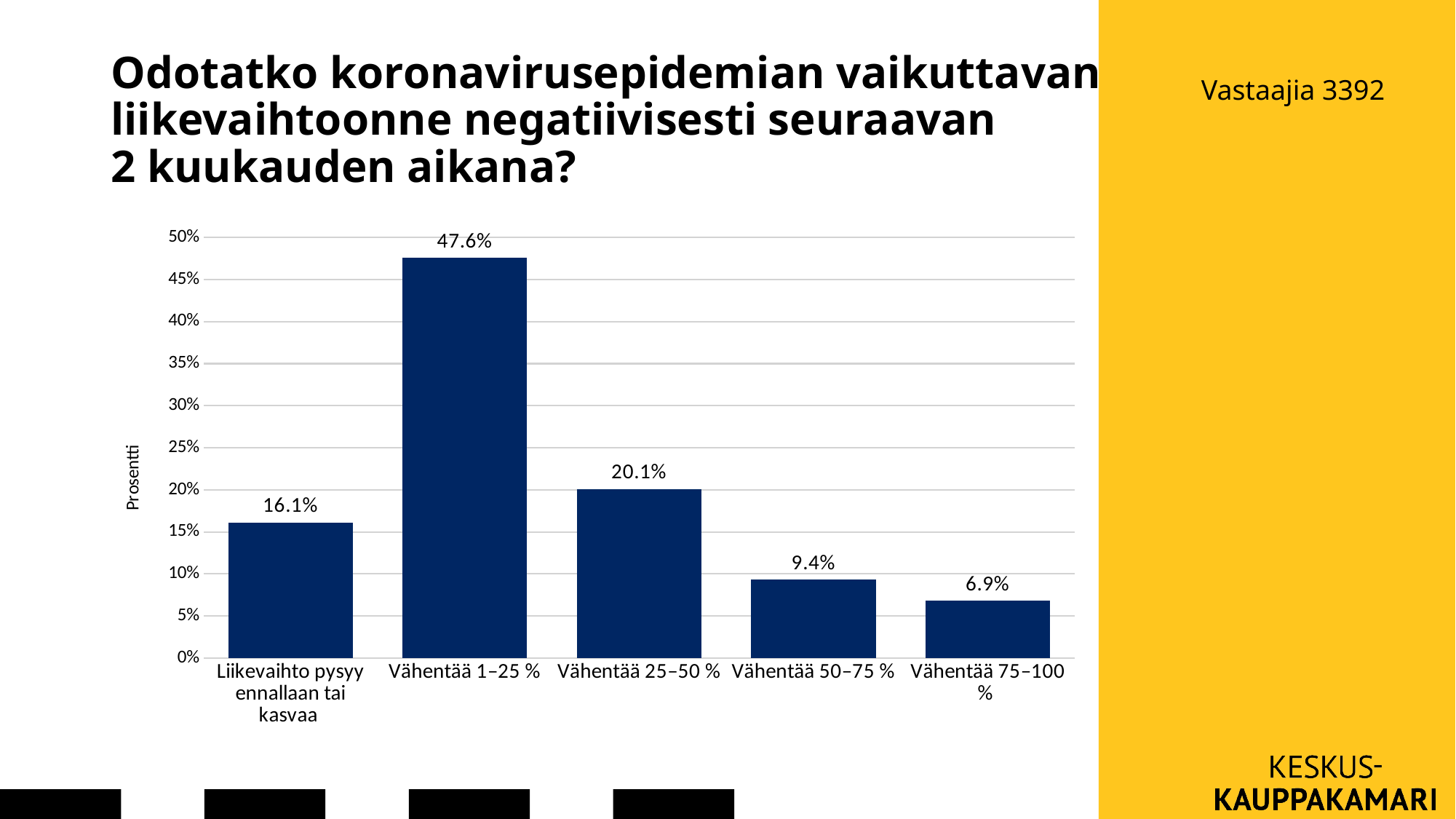
Which is larger: the value for "Liikevaihto pysyy ennallaan tai kasvaa" or the value for "Vähentää 25–50 %"? Vähentää 25–50 % What is the difference between the values for "Vähentää 1–25 %" and "Vähentää 25–50 %"? 27.5% What is the value for "Vähentää 50–75 %"? 9.4% What is the value for "Vähentää 1–25 %"? 47.6% What is the label of the y axis? Prosentti Is the value for "Vähentää 75–100 %" greater or less than 10%? less How many categories are shown on the x axis? 5 How many respondents (Vastaajia) are stated on the slide? 3392 What is the value for "Liikevaihto pysyy ennallaan tai kasvaa"? 16.1% What kind of chart is shown on the slide? bar chart Which category has the highest value? Vähentää 1–25 % Which category has the lowest value? Vähentää 75–100 %